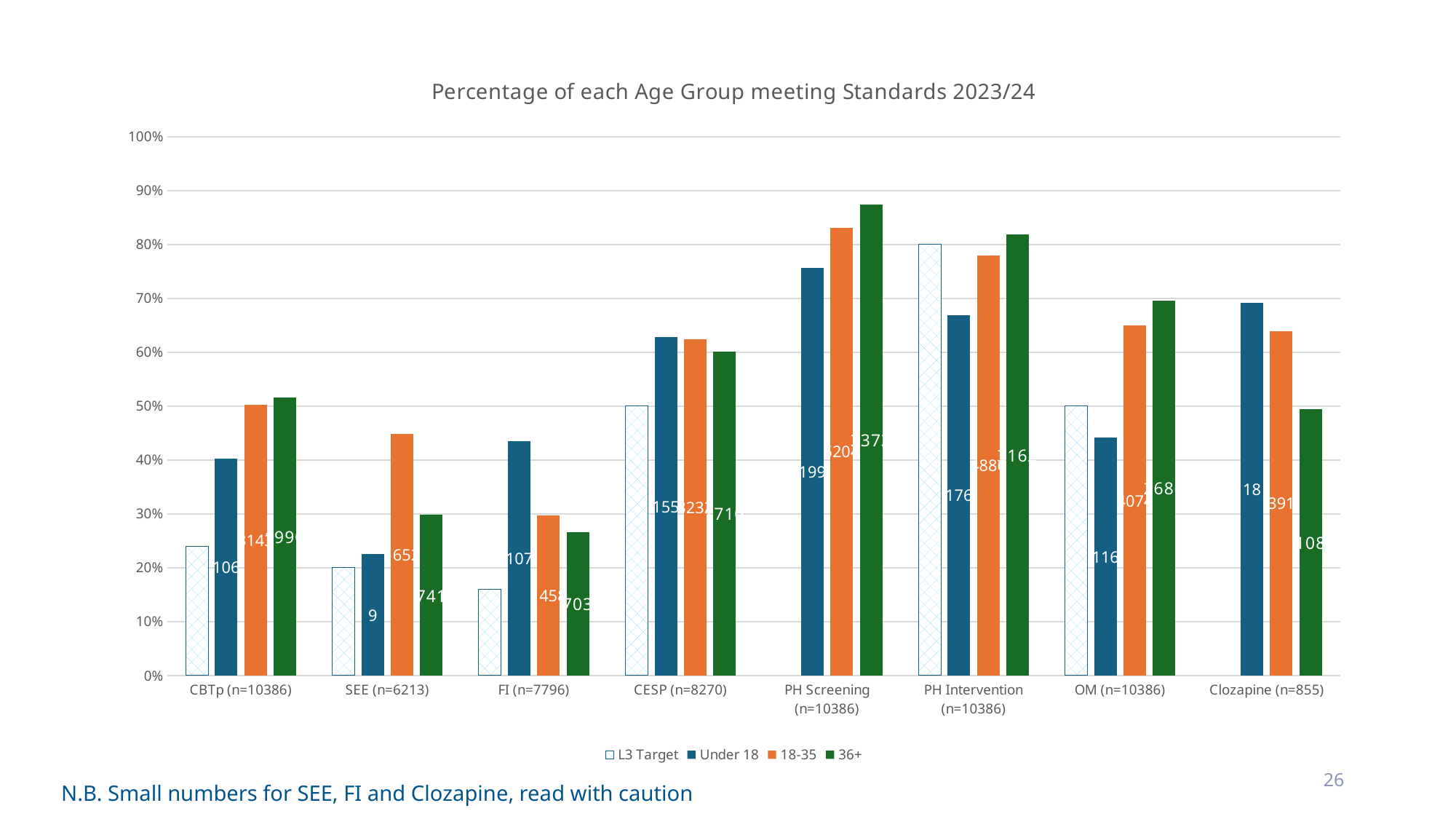
Which category has the lowest Under 18 bar? SEE (n=6213) What is the L3 Target value for PH Intervention (n=10386)? 80% How many series does the legend list? 4 What is the L3 Target value for CESP (n=8270)? 50% How many categories are shown along the x axis? 8 For PH Screening (n=10386), which is larger: the Under 18 value or the 18-35 value? 18-35 Is the 36+ value for PH Screening (n=10386) greater or less than 80%? greater Which category has the highest 36+ bar? PH Screening (n=10386) Is the Under 18 value for CBTp (n=10386) greater or less than 50%? less What kind of chart is shown on the slide? bar chart For Clozapine (n=855), which is larger: the Under 18 value or the 36+ value? Under 18 What is the title of the chart? Percentage of each Age Group meeting Standards 2023/24